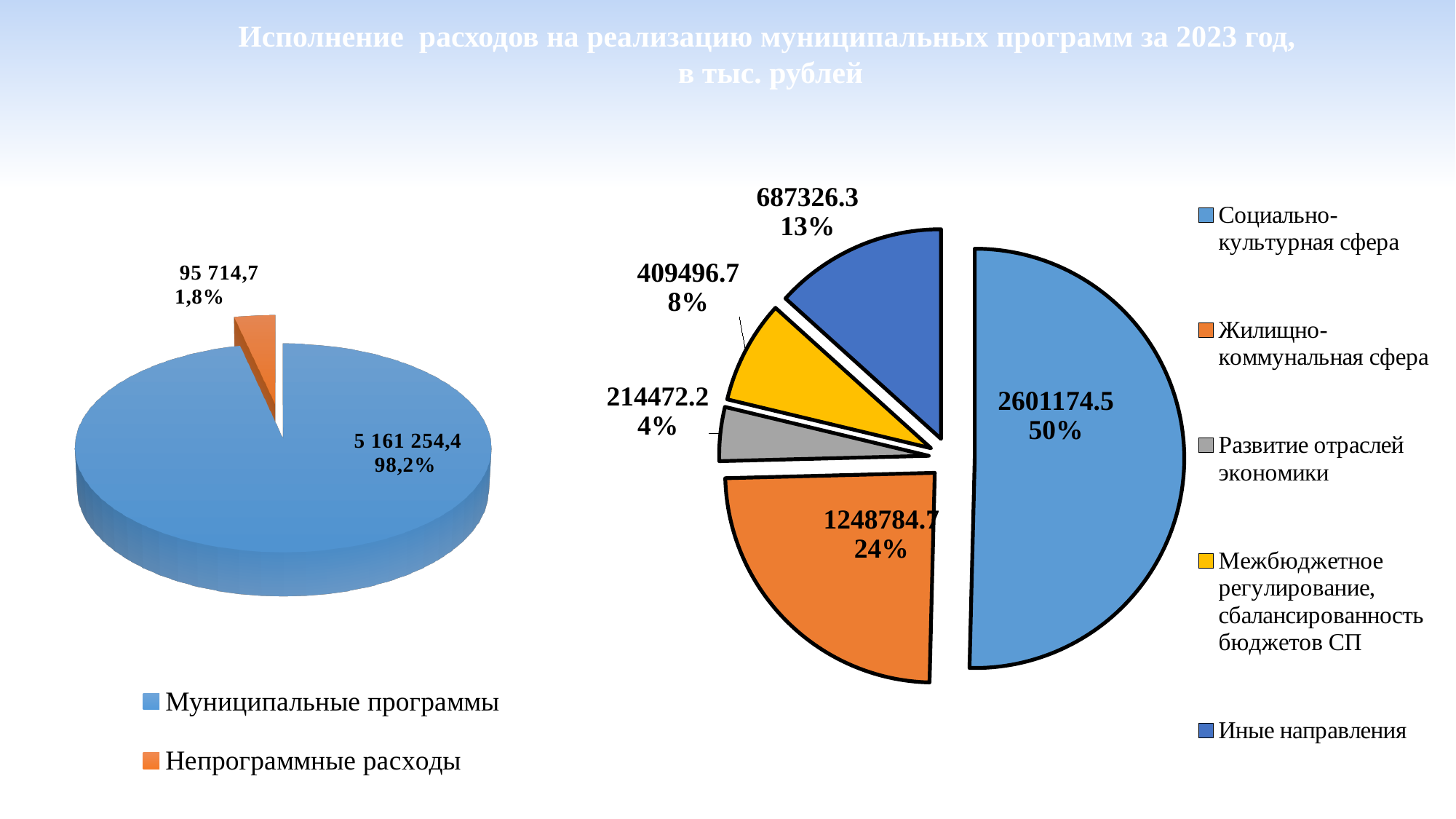
On the right pie chart, how many categories does the legend list? 5 What type of chart is shown on the left of the slide? Pie chart On the left pie chart, what is the value for Муниципальные программы? 5 161 254,4 On the right pie chart, what share of the pie does Иные направления take? 13% On the right pie chart, which category has the largest value? Социально-культурная сфера On the left pie chart, what share of the pie does Муниципальные программы take? 98,2% On the right pie chart, what is the value for Социально-культурная сфера? 2601174.5 On the right pie chart, which category has the smallest value? Развитие отраслей экономики On the right pie chart, which is larger: Межбюджетное регулирование, сбалансированность бюджетов СП or Иные направления? Иные направления On the left pie chart, how many categories are shown? 2 On the right pie chart, what is the value for Жилищно-коммунальная сфера? 1248784.7 On the left pie chart, what share of the pie does Непрограммные расходы take? 1,8%